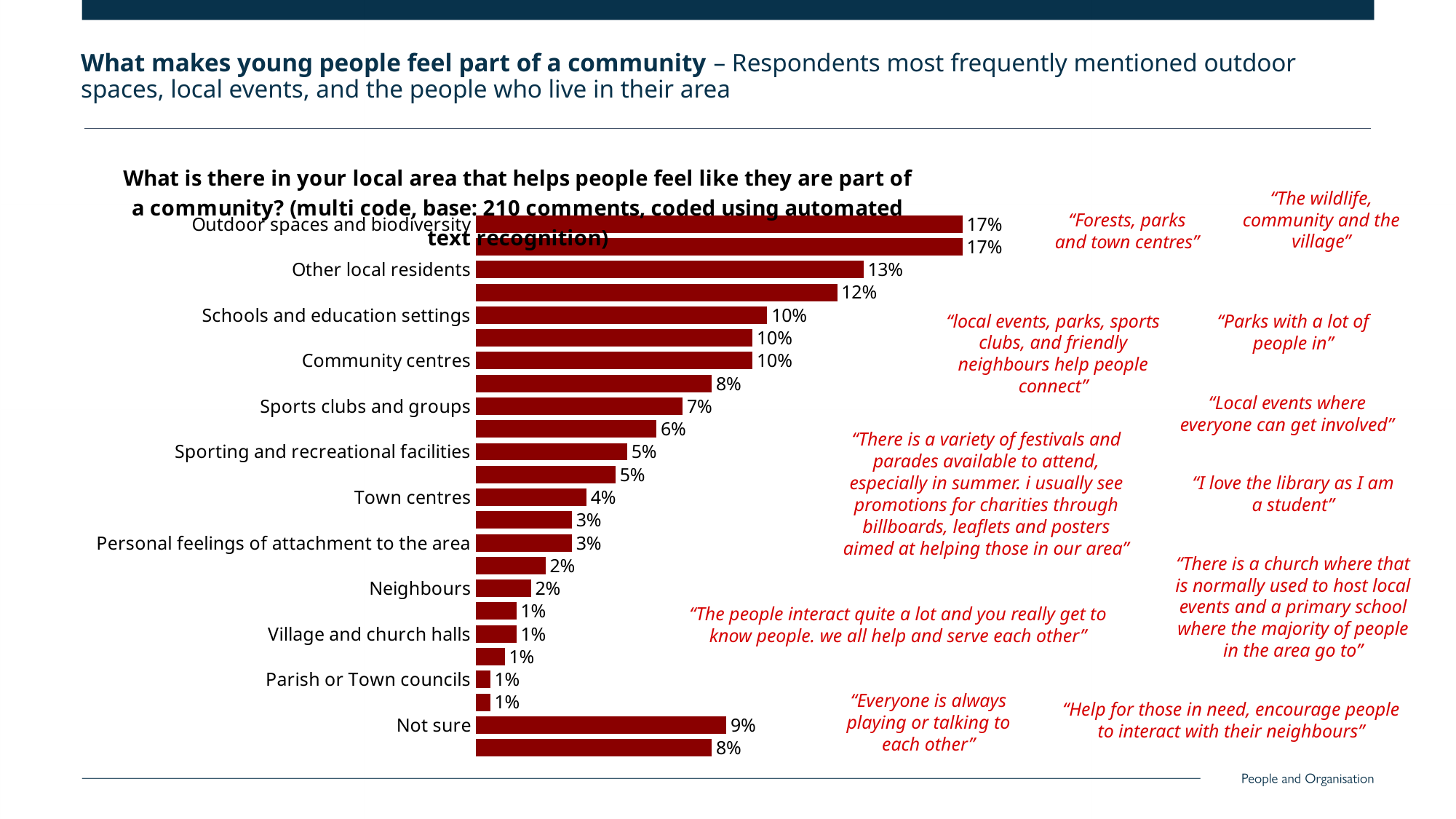
What kind of chart is shown on the slide? Bar chart What is the difference between the values for Schools and education settings and Sports clubs and groups? 3 percentage points What is the value for Sports clubs and groups? 7% According to the chart title, how many comments form the base for the chart? 210 comments What is the value for Neighbours? 2% What is the value for Outdoor spaces and biodiversity? 17% What is the value for Not sure? 9% Which labelled category has the highest value? Outdoor spaces and biodiversity What is the difference between the values for Outdoor spaces and biodiversity and Other local residents? 4 percentage points Which is larger, the value for Not sure or the value for Sports clubs and groups? Not sure What is the value for Other local residents? 13% What is the value for Town centres? 4%